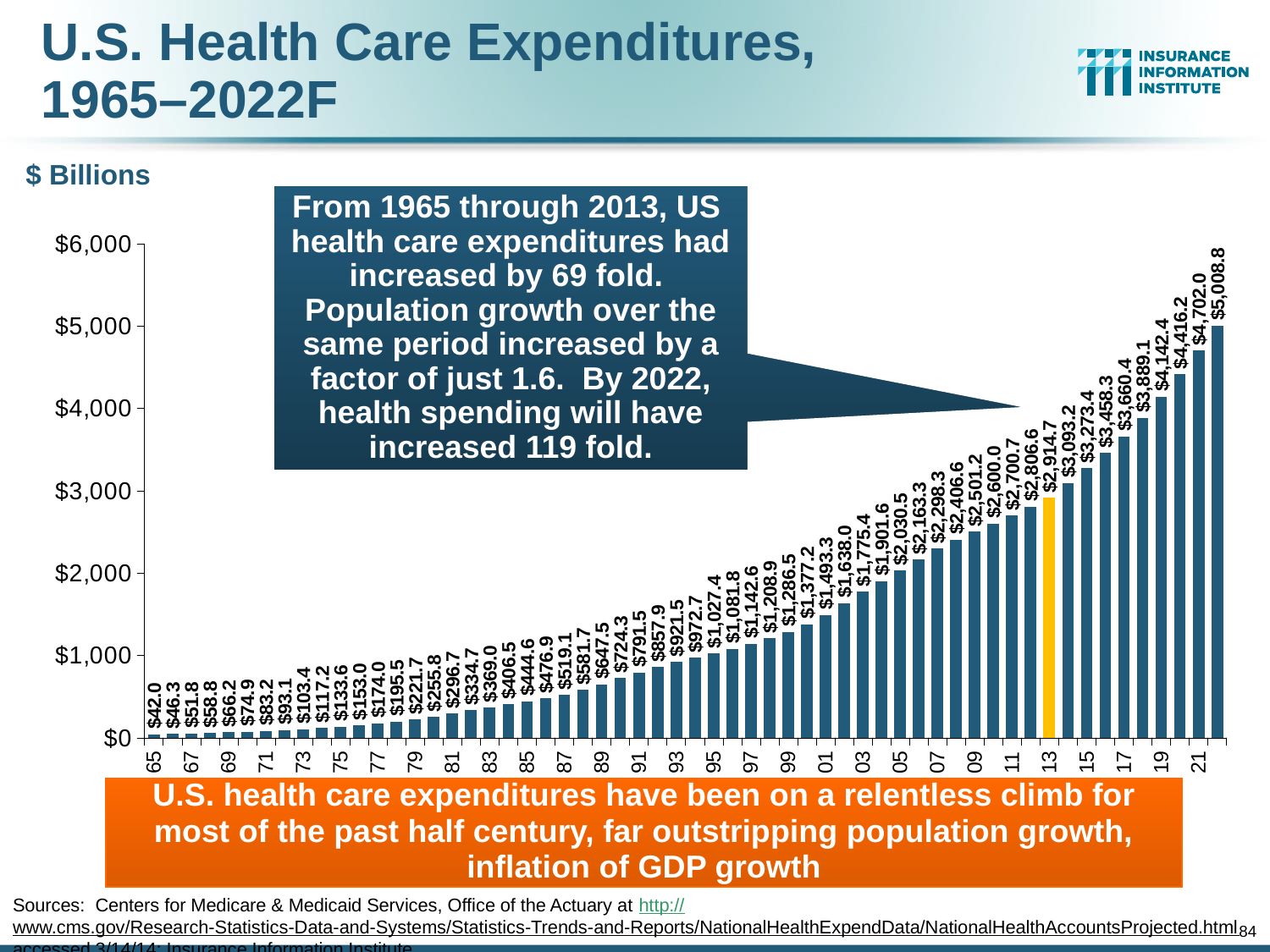
Is the value for 2011 (labeled 11) greater or less than $2,000? greater What is the difference between the 2022 value ($5,008.8) and the 2013 value ($2,914.7)? $2,094.1 What is the value of the bar for 2001 (labeled 01)? $1,493.3 Which year has the highest health care expenditure value? 2022 What is the value of the bar for 1965 (labeled 65)? $42.0 What is the value of the last bar, for 2022? $5,008.8 What is the value of the highlighted bar for 2013 (labeled 13)? $2,914.7 Which year has the lowest health care expenditure value? 1965 Which is larger, the value for 1995 (labeled 95) or the value for 2005 (labeled 05)? 2005 Do the values generally rise or fall from left to right along the x axis? rise What unit is shown above the y axis of the chart? $ Billions What type of chart is shown on the slide? bar chart